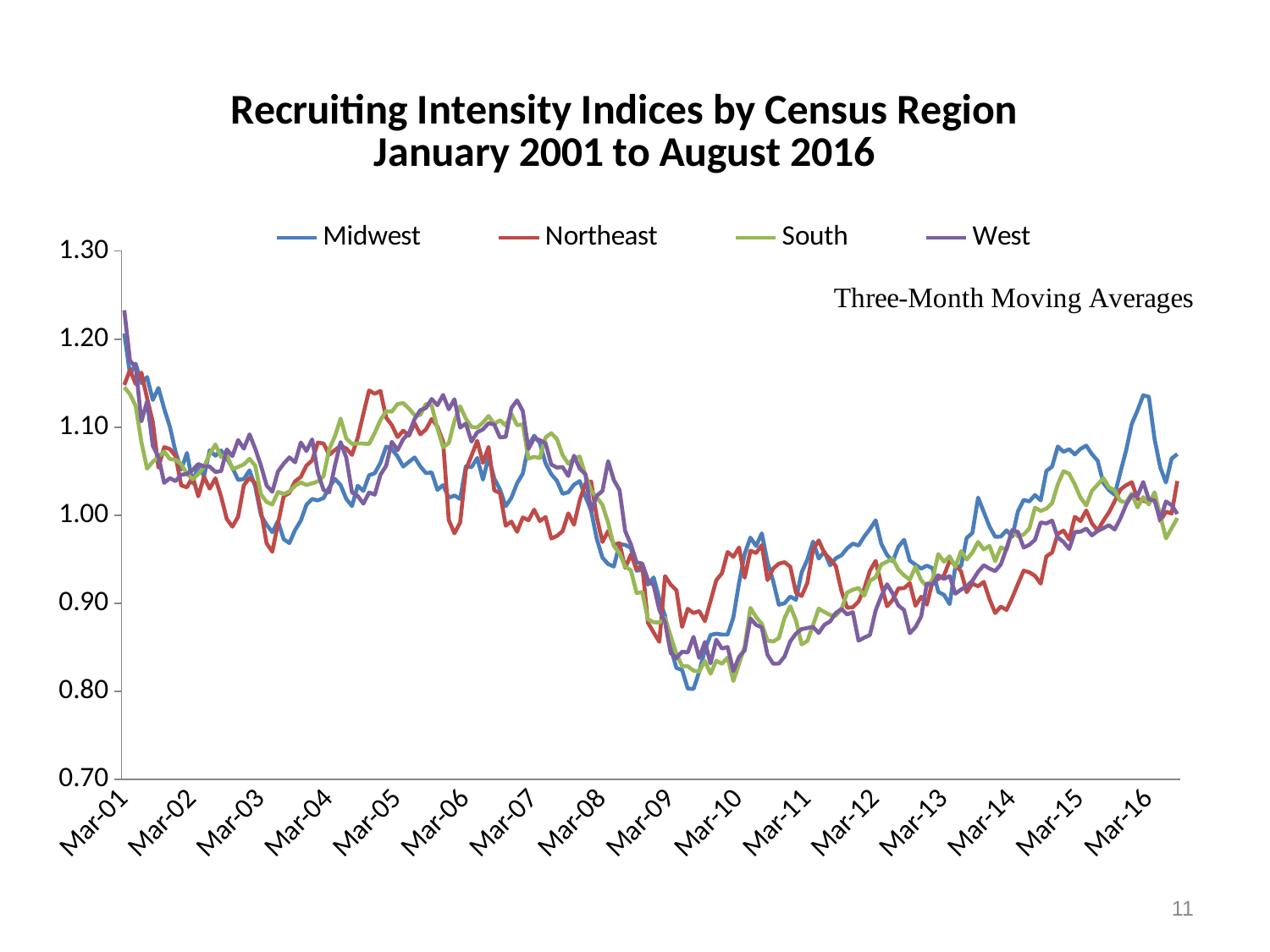
How many date labels are shown on the x axis? 16 What note is printed inside the plot area of the chart? Three-Month Moving Averages Does the Midwest series rise or fall between Mar-08 and Mar-09? Fall Is the value for Midwest at Mar-01 greater or less than 1.10? greater Is the value for West at Mar-10 greater or less than 0.90? less What kind of chart is shown on the slide? Line chart What is the title of the chart? Recruiting Intensity Indices by Census Region January 2001 to August 2016 Does the Midwest series rise or fall between Mar-13 and Mar-15? Rise At Mar-15, which series has the larger value, Midwest or Northeast? Midwest Is the value for Midwest at Mar-15 greater or less than 1.00? greater How many series does the legend list? 4